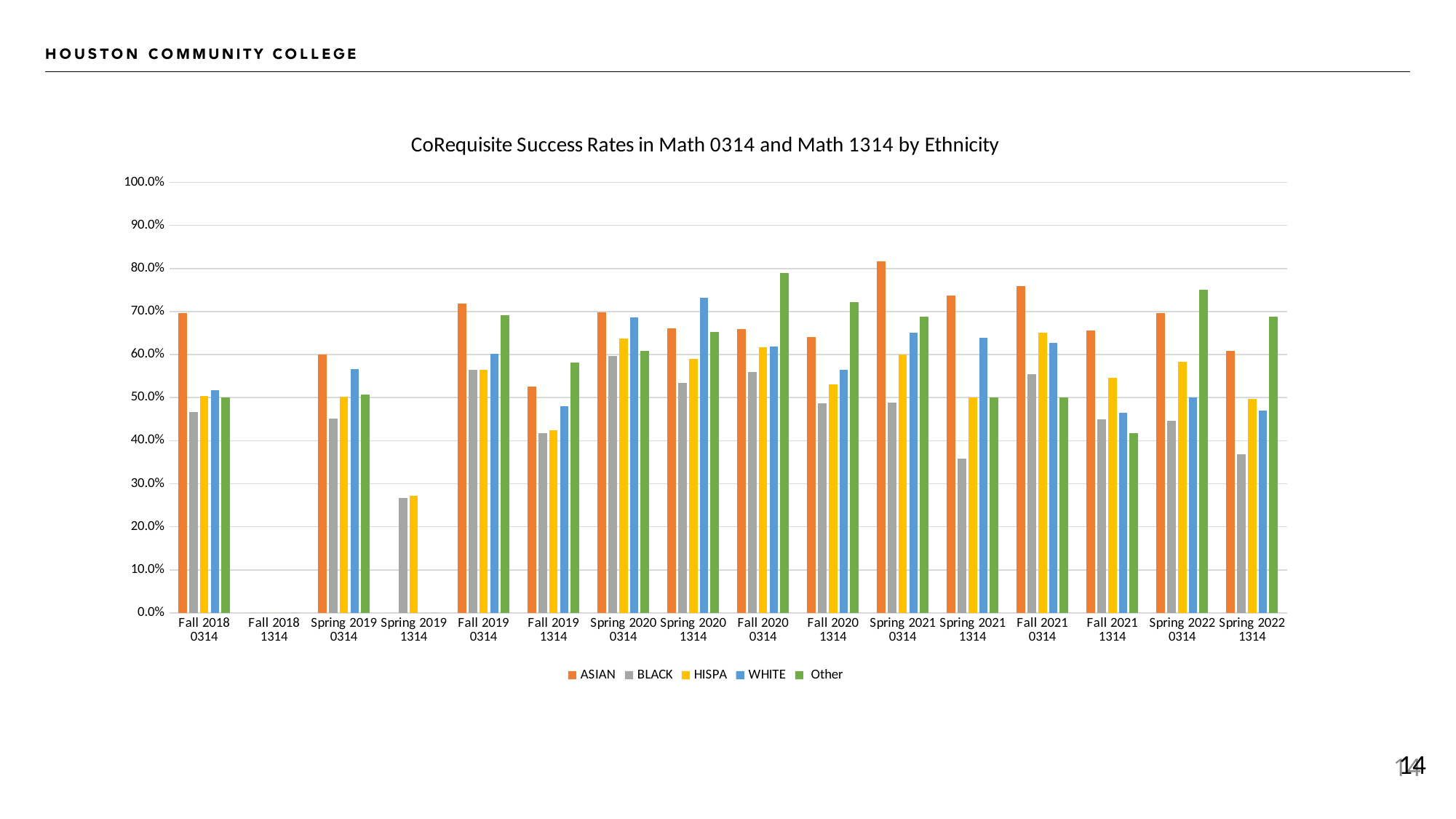
Which series has the lowest value in Spring 2021 1314? BLACK In Spring 2020 1314, which is larger: the WHITE value or the ASIAN value? WHITE How many series does the legend list? 5 Which series has the highest value in Fall 2020 0314? Other Is the value for Other in Fall 2020 0314 greater or less than 70%? greater How many categories are shown along the x axis? 16 Is the value for BLACK in Spring 2019 1314 greater or less than 30%? less What kind of chart is shown on the slide? bar chart What is the title of the chart? CoRequisite Success Rates in Math 0314 and Math 1314 by Ethnicity Is the value for BLACK in Spring 2022 1314 greater or less than 40%? less Which colour represents the Other series in the legend? green